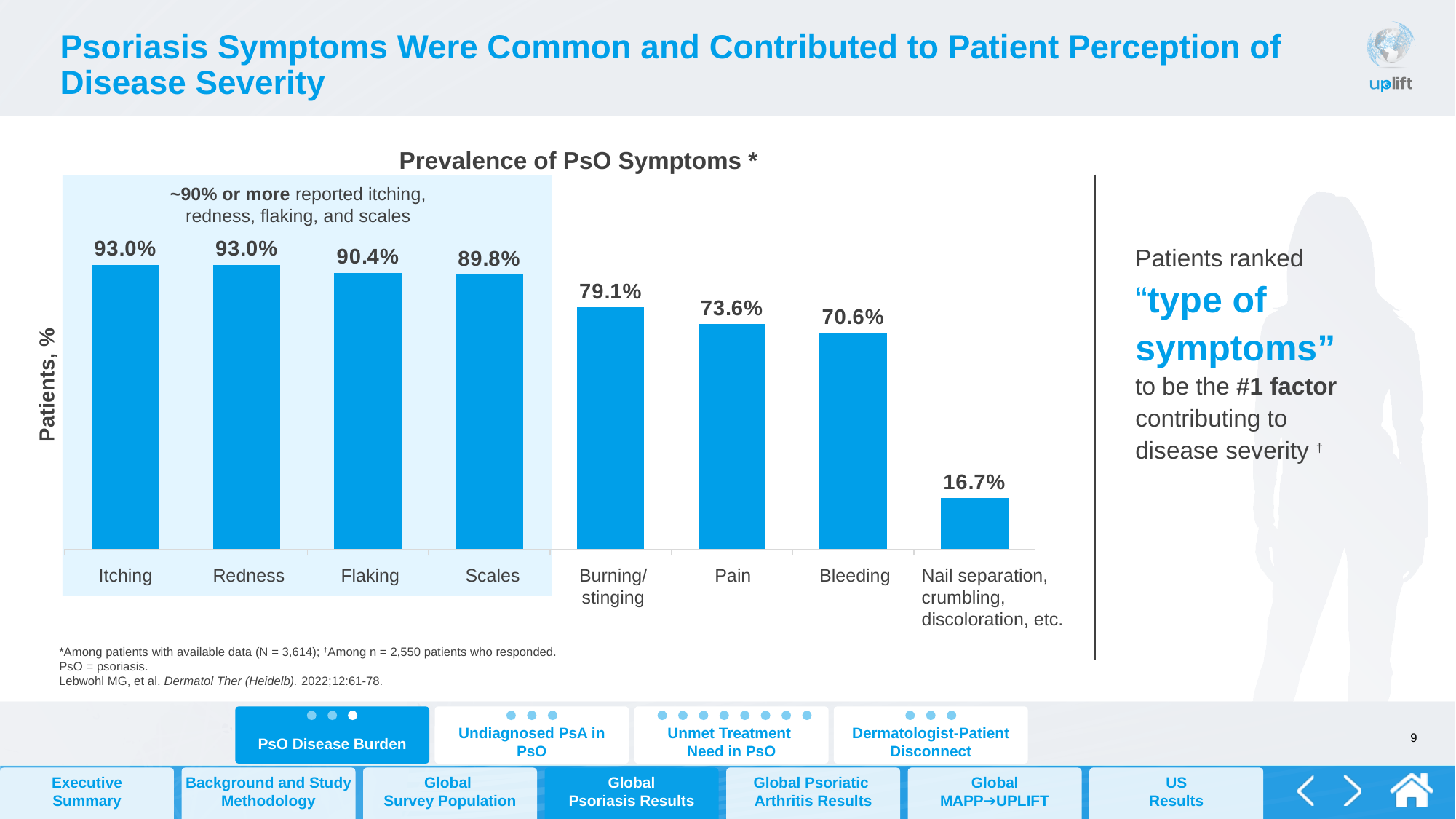
What percentage of patients reported burning/stinging? 79.1% What is the value for Bleeding? 70.6% How many symptom categories are shown in the chart? 8 What is the difference between the values for Flaking and Nail separation, crumbling, discoloration, etc.? 73.7% What is the value for Flaking? 90.4% What percentage of patients reported itching? 93.0% Which symptom has the lowest prevalence? Nail separation, crumbling, discoloration, etc. Which is larger, the value for Pain or the value for Bleeding? Pain What kind of chart is shown on the slide? Bar chart Do the values rise or fall moving from left to right across the categories? Fall What is the difference between the values for Scales and Pain? 16.2% What is the title of the chart? Prevalence of PsO Symptoms *